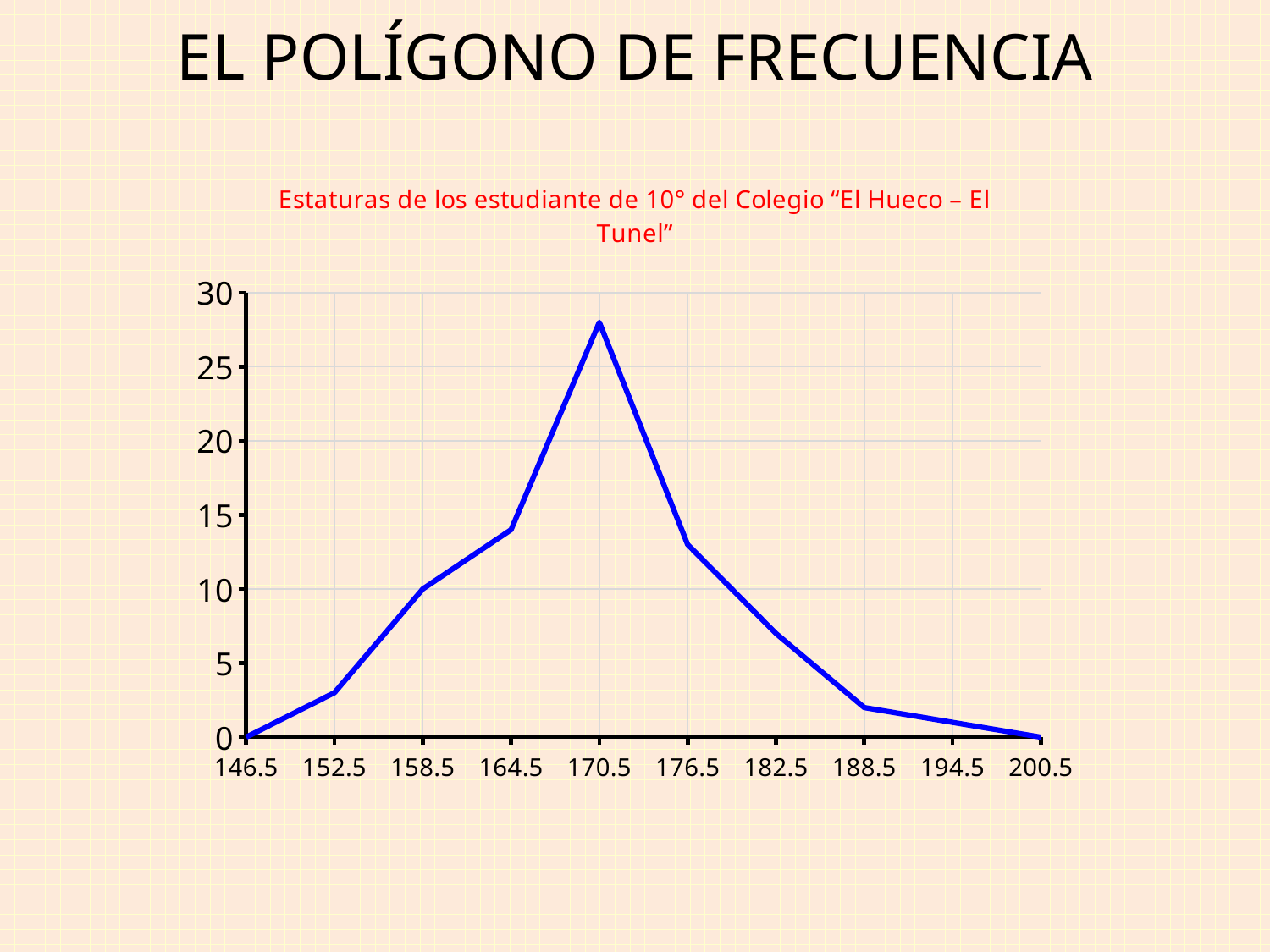
Is the value at 170.5 greater or less than 25? greater Which has the larger value, 170.5 or 164.5? 170.5 Is the value at 176.5 greater or less than 10? greater Does the line rise or fall between 146.5 and 170.5? rise Is the value at 188.5 greater or less than 5? less How many points are plotted on the line? 10 At which x-axis value does the line reach its highest point? 170.5 What is the value at 200.5? 0 What is the value at 146.5? 0 What is the title of the chart? Estaturas de los estudiante de 10° del Colegio "El Hueco – El Tunel" What kind of chart is shown on the slide? line chart